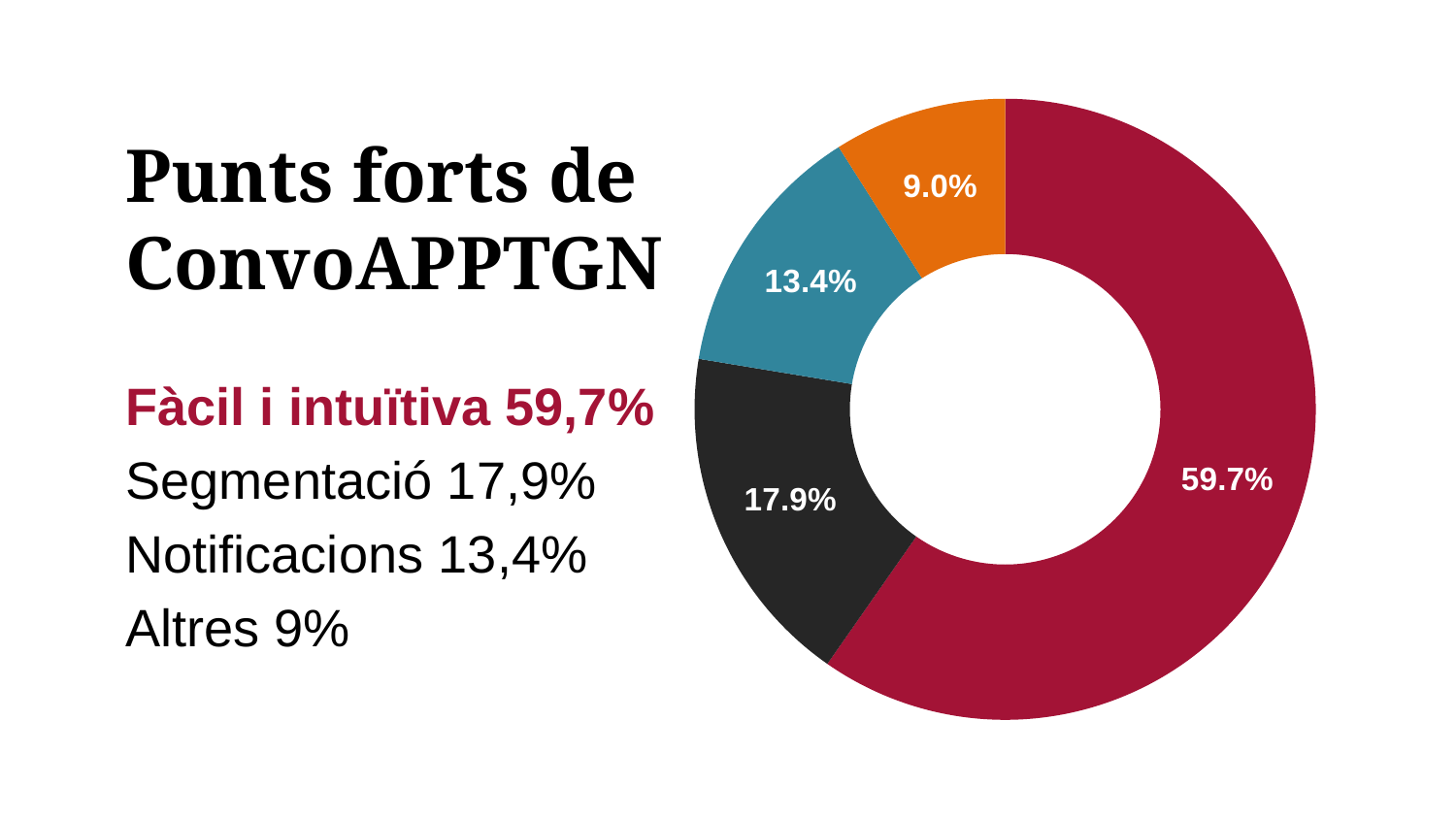
What is the difference between the largest slice (59.7%) and the second largest slice (17.9%) in the donut chart? 41.8 percentage points What is the title shown on the slide next to the donut chart? Punts forts de ConvoAPPTGN What share of the donut chart does the teal slice represent? 13.4% According to the slide text, which strong point of ConvoAPPTGN corresponds to the 59.7% slice? Fàcil i intuïtiva Which slice is larger in the donut chart, the black slice or the teal slice? The black slice (17.9%) What share of the donut chart does the black slice represent? 17.9% What percentage is shown on the largest slice of the donut chart? 59.7% According to the slide text, what percentage corresponds to Notificacions? 13,4% How many slices does the donut chart have? 4 What kind of chart is shown on the slide? Pie chart (donut) What share of the donut chart does the orange slice represent? 9.0% What percentage is shown on the smallest slice of the donut chart? 9.0%